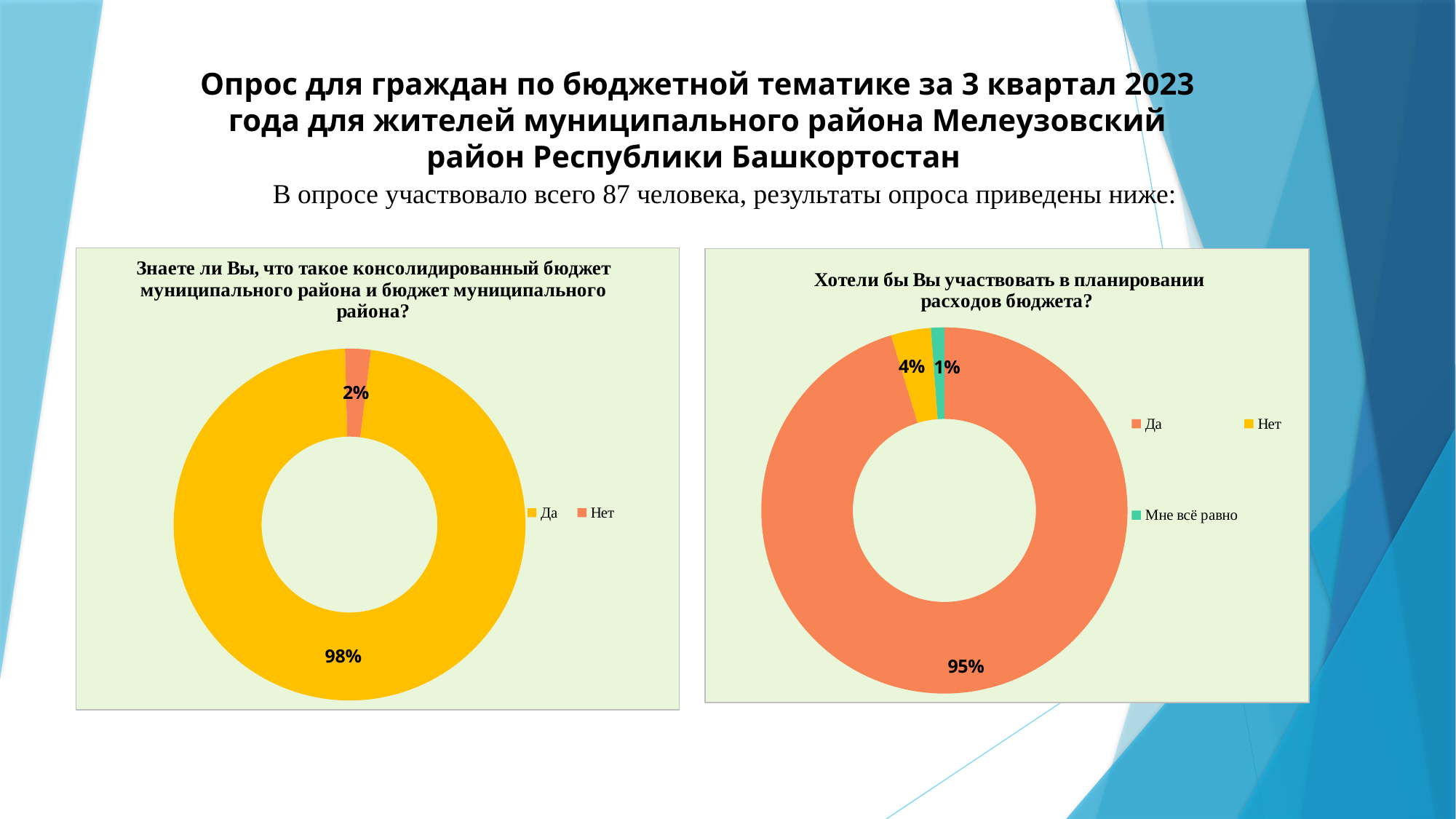
In the right chart, what share answered "Нет"? 4% In the left chart, which is larger: the share for "Да" or for "Нет"? Да In the left chart, which answer has the largest share? Да In the right chart ("Хотели бы Вы участвовать в планировании расходов бюджета?"), what share answered "Да"? 95% In the right chart, which answer has the smallest share? Мне всё равно In the right chart, what share answered "Мне всё равно"? 1% In the left chart, what share of respondents answered "Нет"? 2% In the right chart, what colour represents "Мне всё равно"? Green How many categories does the legend of the right chart list? 3 In the left chart ("Знаете ли Вы, что такое консолидированный бюджет..."), what share of respondents answered "Да"? 98% In the right chart, what is the difference in percentage points between "Да" and "Нет"? 91 What type of chart is the left chart? Doughnut (pie) chart